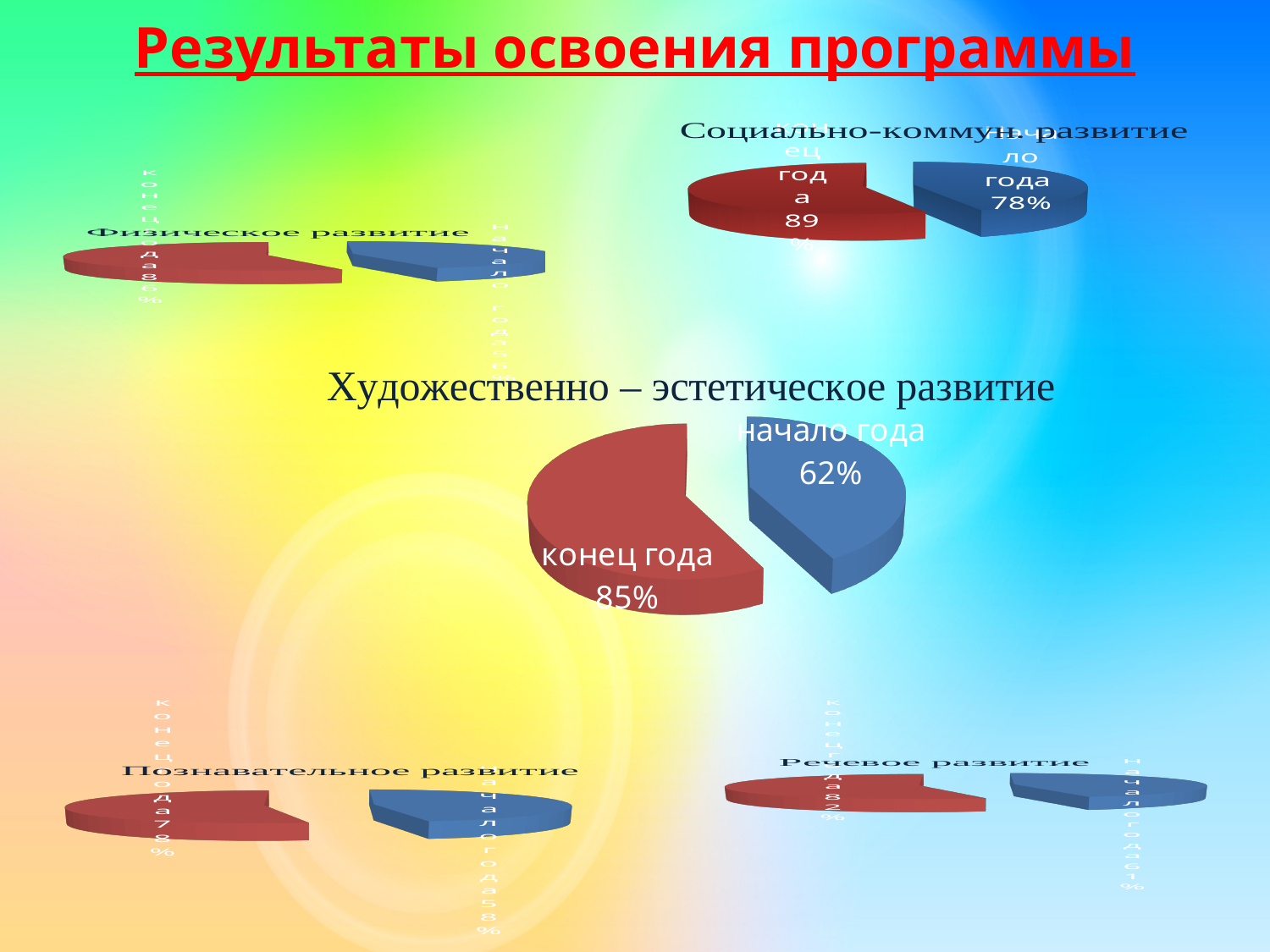
In the 'Художественно – эстетическое развитие' chart, what is the value for 'начало года'? 62% How many charts are shown on the slide? 5 In the 'Художественно – эстетическое развитие' chart, which slice is larger, 'начало года' or 'конец года'? конец года In the 'Художественно – эстетическое развитие' chart, what is the value for 'конец года'? 85% In the 'Художественно – эстетическое развитие' chart, what colour is the 'конец года' slice? red In the 'Социально-коммун. развитие' chart, what is the value for 'начало года'? 78% How many slices does the 'Художественно – эстетическое развитие' pie chart have? 2 What kind of chart is the 'Художественно – эстетическое развитие' chart? pie chart In the 'Социально-коммун. развитие' chart, what is the value for 'конец года'? 89% What is the title of the chart in the centre of the slide? Художественно – эстетическое развитие In the 'Социально-коммун. развитие' chart, what is the difference between 'конец года' and 'начало года'? 11 percentage points In the 'Художественно – эстетическое развитие' chart, what is the difference between 'конец года' and 'начало года'? 23 percentage points